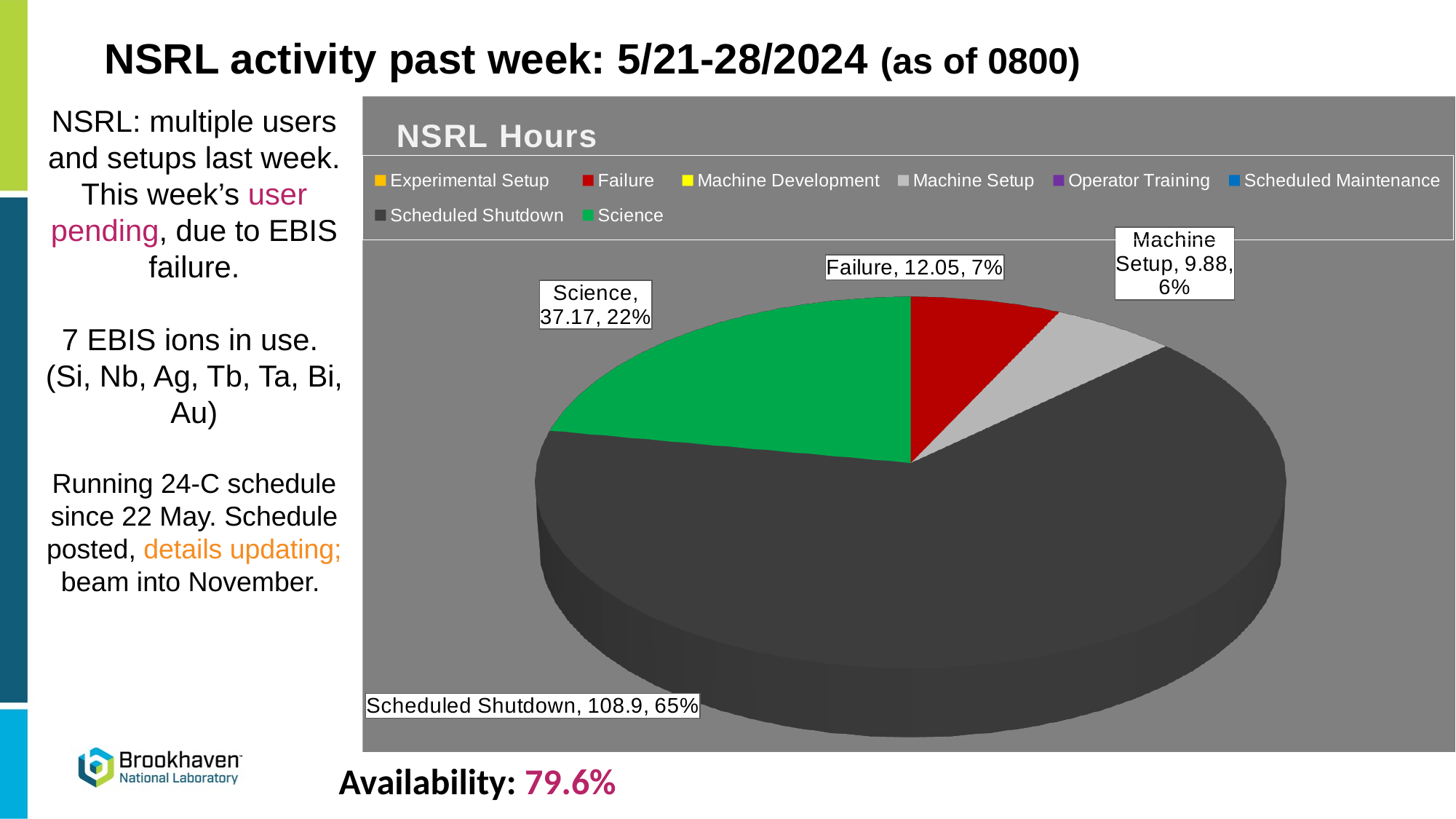
How many entries does the chart's legend list? 8 How many hours are labelled for Science? 37.17 Which labelled category has the smallest slice of the pie? Machine Setup What kind of chart is shown on the slide? pie chart What is the title of the chart? NSRL Hours How many hours are labelled for Scheduled Shutdown? 108.9 How many hours are labelled for Failure? 12.05 Which labelled category has the largest slice of the pie? Scheduled Shutdown What share of the pie does Science take? 22% Which has more hours, Failure or Science? Science What share of the pie does Scheduled Shutdown take? 65% How many hours are labelled for Machine Setup? 9.88